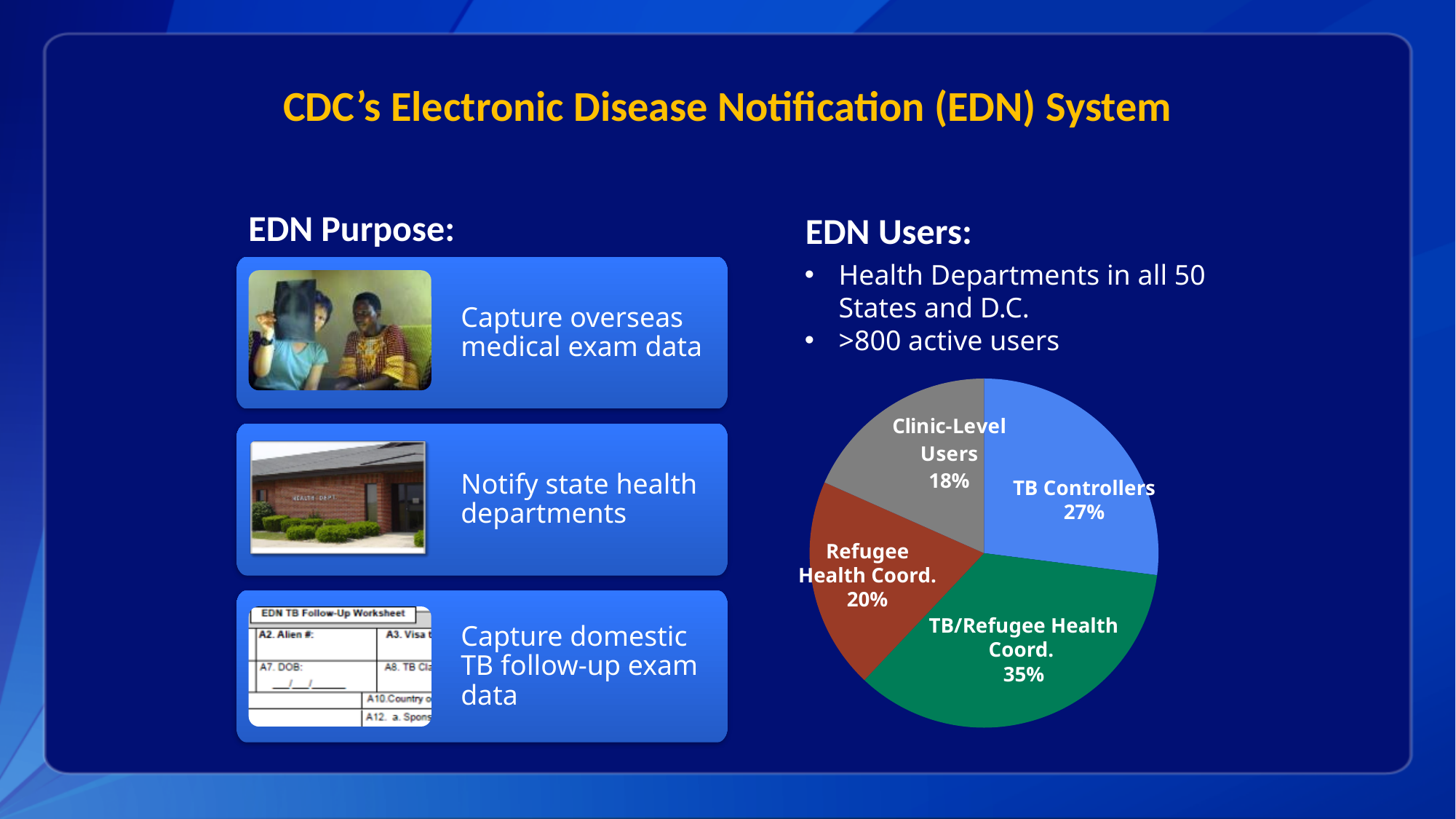
What kind of chart is shown on the slide? pie chart Which is larger, the share for Refugee Health Coord. or the share for Clinic-Level Users? Refugee Health Coord. What share of EDN users are Clinic-Level Users? 18% What is the combined share of TB Controllers and Clinic-Level Users? 45% Which user group has the largest slice of the pie chart? TB/Refugee Health Coord. What is the difference in percentage points between TB/Refugee Health Coord. and TB Controllers? 8 Which user group has the smallest slice of the pie chart? Clinic-Level Users How many slices does the pie chart have? 4 What share of EDN users are Refugee Health Coord.? 20% What share of EDN users are TB/Refugee Health Coord.? 35% What share of EDN users are TB Controllers? 27% What colour is the slice for TB/Refugee Health Coord. in the pie chart? green